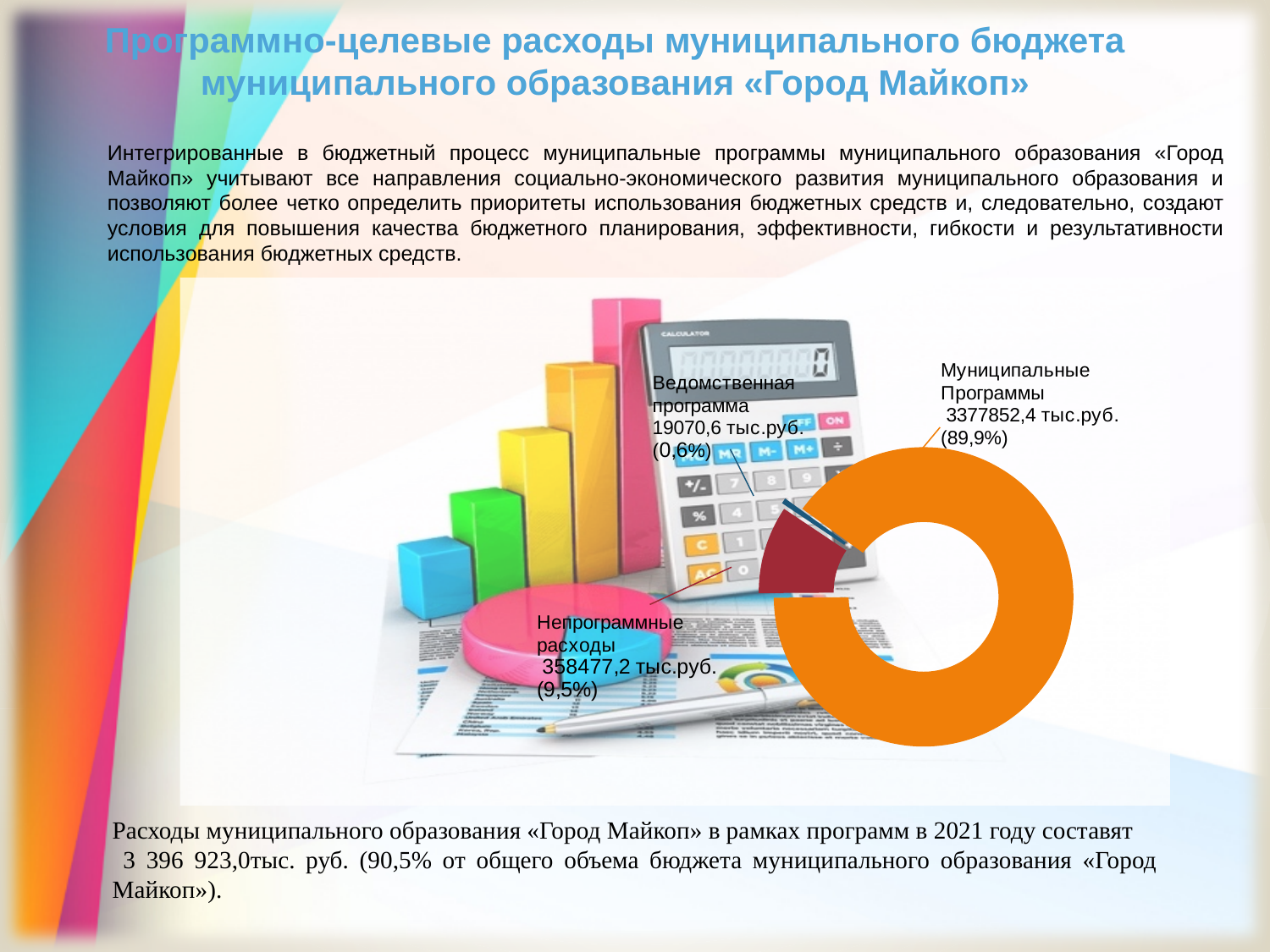
Which category has the smallest share of the doughnut chart? Ведомственная программа What is the value for Муниципальные Программы? 3377852,4 тыс.руб. Which is larger: Непрограммные расходы or Ведомственная программа? Непрограммные расходы Which category has the largest share of the doughnut chart? Муниципальные Программы What share of the chart does Ведомственная программа represent? 0,6% What is the value for Ведомственная программа? 19070,6 тыс.руб. What share of the chart does Непрограммные расходы represent? 9,5% What is the difference between the values for Непрограммные расходы and Ведомственная программа? 339406,6 тыс.руб. What share of the chart does Муниципальные Программы represent? 89,9% How many categories does the doughnut chart show? 3 What kind of chart is shown on the slide? Doughnut (pie) chart What is the value for Непрограммные расходы? 358477,2 тыс.руб.